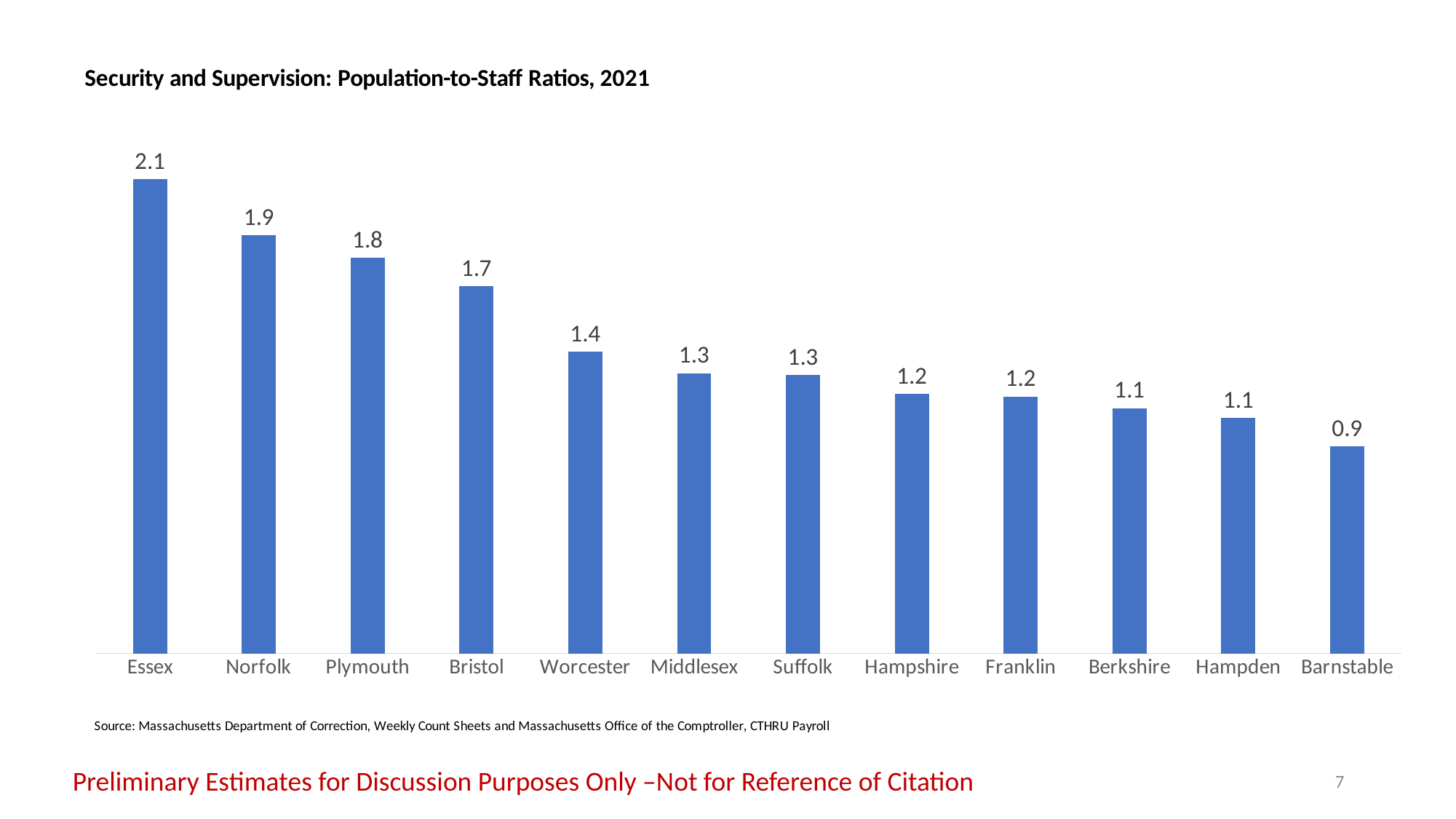
What is the population-to-staff ratio for Worcester? 1.4 What is the population-to-staff ratio for Essex? 2.1 Which county has the lowest population-to-staff ratio? Barnstable What is the population-to-staff ratio for Barnstable? 0.9 What is the title of the chart? Security and Supervision: Population-to-Staff Ratios, 2021 What kind of chart is shown on the slide? Bar chart What is the difference between the ratios for Essex and Barnstable? 1.2 Which county has the highest population-to-staff ratio? Essex Do the values rise or fall moving from left to right along the x axis? Fall What is the difference between the ratios for Norfolk and Bristol? 0.2 How many counties are shown in the chart? 12 Which has a higher population-to-staff ratio, Plymouth or Middlesex? Plymouth